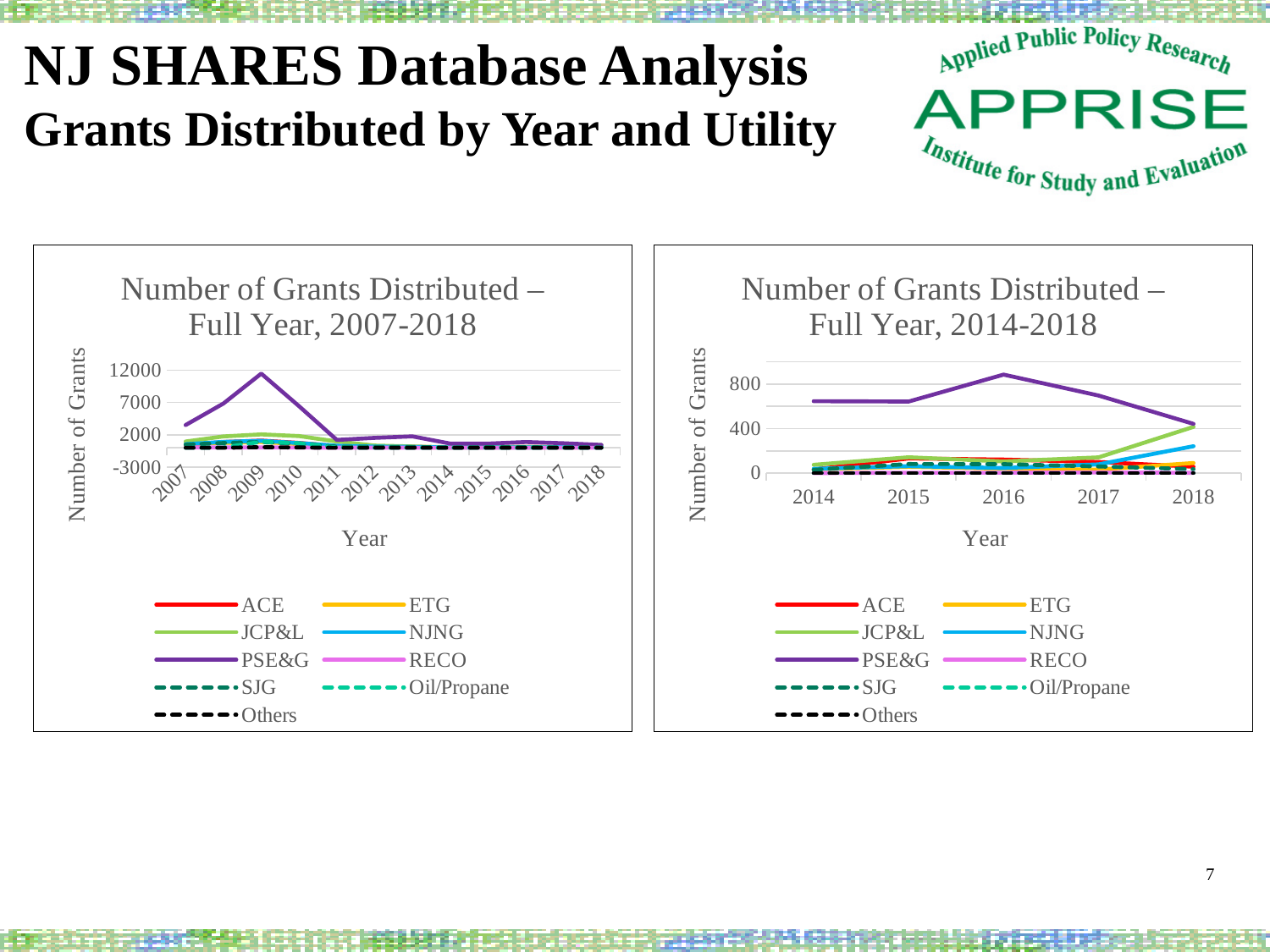
How many series does the legend of the right chart, 'Number of Grants Distributed – Full Year, 2014-2018', list? 9 What is the y-axis label of the left chart, 'Number of Grants Distributed – Full Year, 2007-2018'? Number of Grants What kind of chart is the left chart, 'Number of Grants Distributed – Full Year, 2007-2018'? Line chart In the right chart, 'Number of Grants Distributed – Full Year, 2014-2018', is the value for PSE&G in 2016 greater or less than 800? greater How many years are shown on the x axis of the right chart, 'Number of Grants Distributed – Full Year, 2014-2018'? 5 In the right chart, 'Number of Grants Distributed – Full Year, 2014-2018', which utility has the highest number of grants in 2016? PSE&G How many years are shown on the x axis of the left chart, 'Number of Grants Distributed – Full Year, 2007-2018'? 12 In the right chart, 'Number of Grants Distributed – Full Year, 2014-2018', does the PSE&G line rise or fall from 2016 to 2018? Fall In the left chart, 'Number of Grants Distributed – Full Year, 2007-2018', is the value for PSE&G in 2009 greater or less than 7000? greater In the right chart, 'Number of Grants Distributed – Full Year, 2014-2018', which is larger in 2015: PSE&G or JCP&L? PSE&G In the right chart, 'Number of Grants Distributed – Full Year, 2014-2018', is the value for NJNG in 2018 greater or less than 400? less In the left chart, 'Number of Grants Distributed – Full Year, 2007-2018', which utility has the highest number of grants in 2009? PSE&G